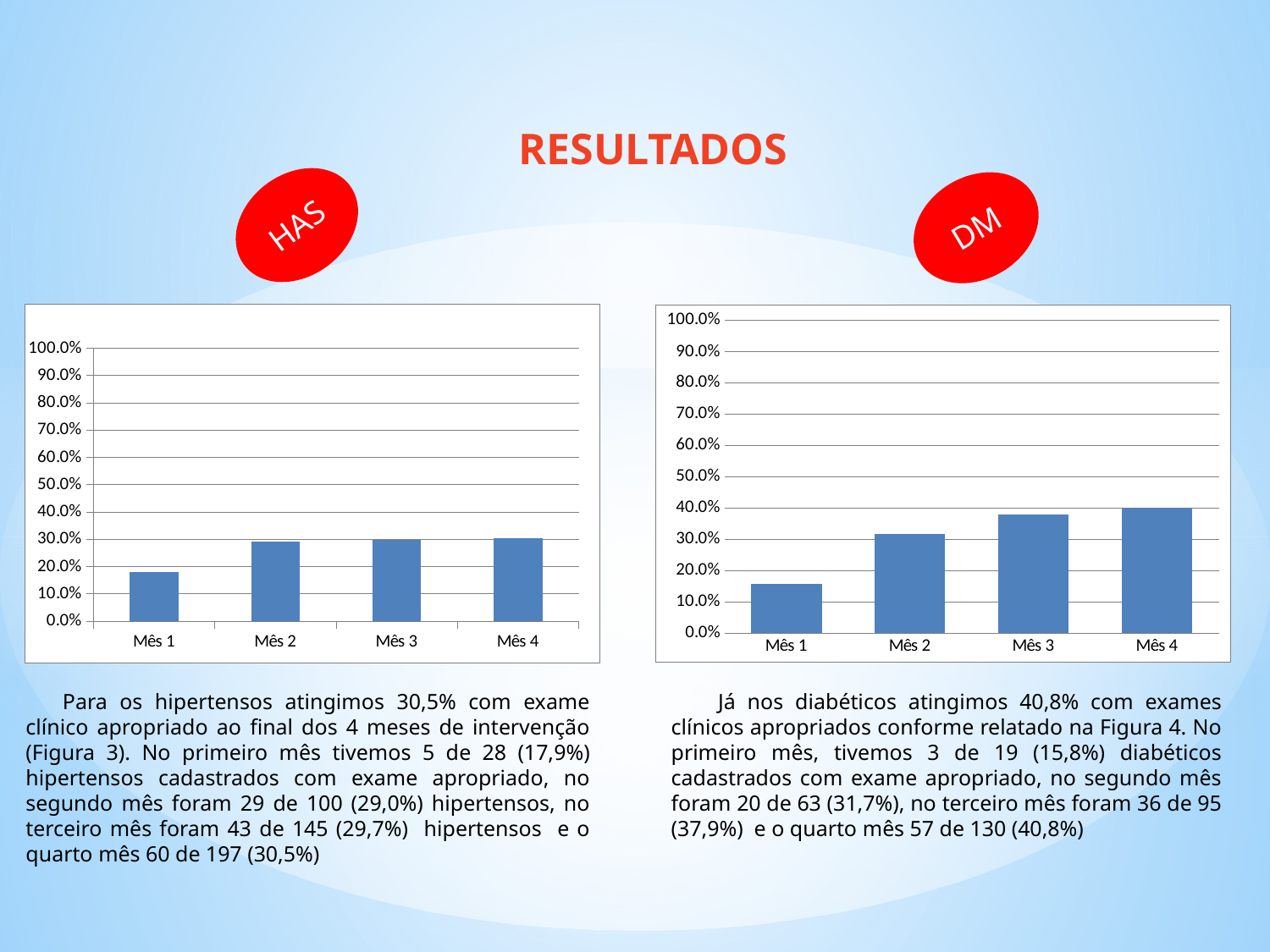
What kind of chart is the HAS chart on the left? bar chart On the HAS chart on the left, which month has the lowest value? Mês 1 On the DM chart on the right, do the values rise or fall from Mês 1 to Mês 4? rise On the DM chart on the right, which is larger, the value for Mês 2 or Mês 3? Mês 3 On the HAS chart on the left, which is larger, the value for Mês 1 or Mês 2? Mês 2 On the DM chart on the right, is the value for Mês 4 greater or less than 30.0%? greater On the DM chart on the right, which month has the lowest value? Mês 1 On the DM chart on the right, is the value for Mês 3 greater or less than 40.0%? less On the HAS chart on the left, is the value for Mês 3 greater or less than 20.0%? greater How many months (categories) are shown on the DM chart on the right? 4 What is the highest value shown on the y axis of the HAS chart on the left? 100.0%